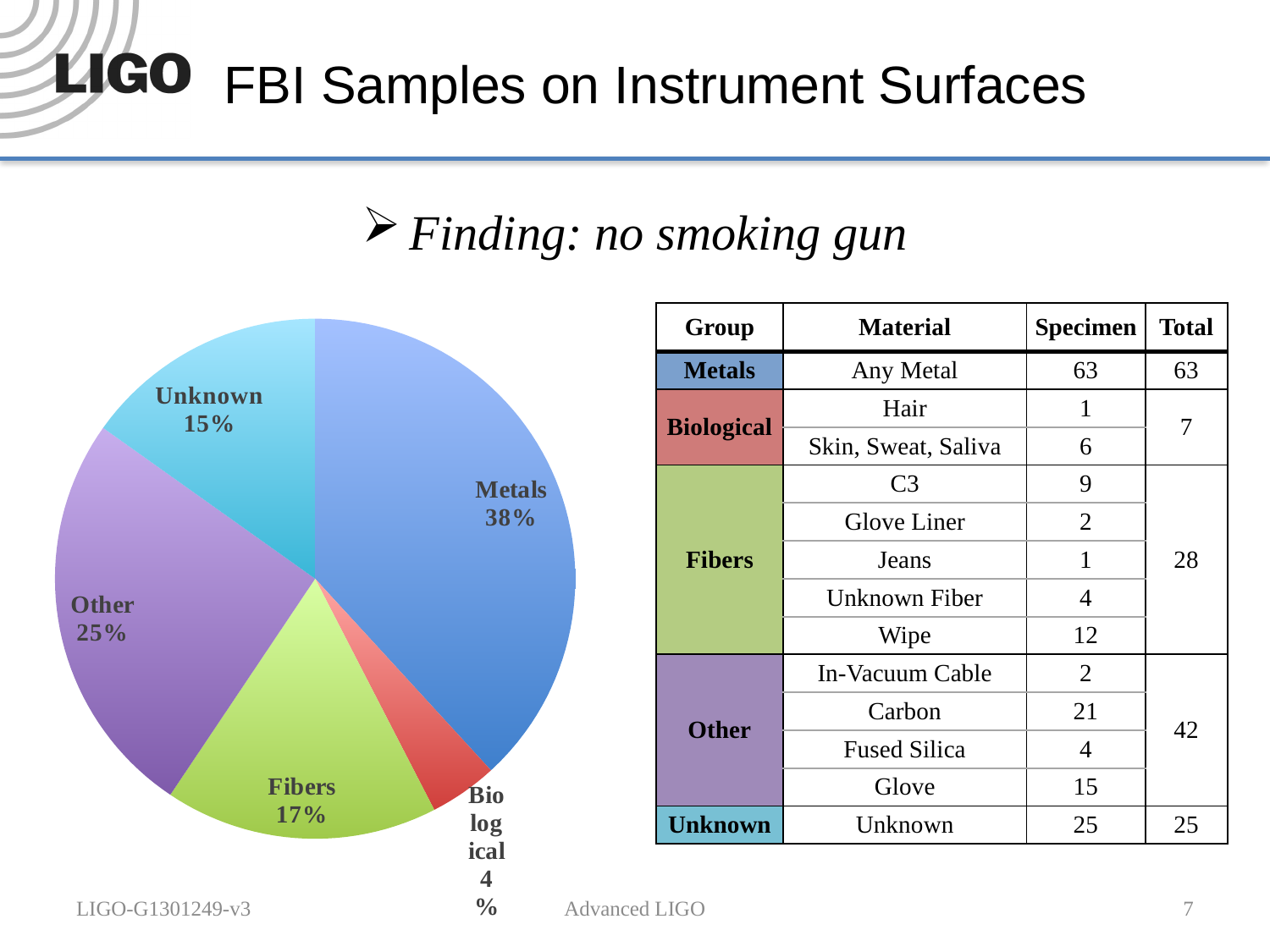
What colour is the Metals slice in the pie chart? blue What kind of chart is shown on the slide? pie chart What share of the pie does Other represent? 25% What share of the pie does Metals represent? 38% What share of the pie does Fibers represent? 17% What is the difference in percentage points between the Metals slice and the Other slice? 13 Which slice is larger, Fibers or Unknown? Fibers Which slice of the pie chart is the largest? Metals How many slices does the pie chart have? 5 Which slice of the pie chart is the smallest? Biological